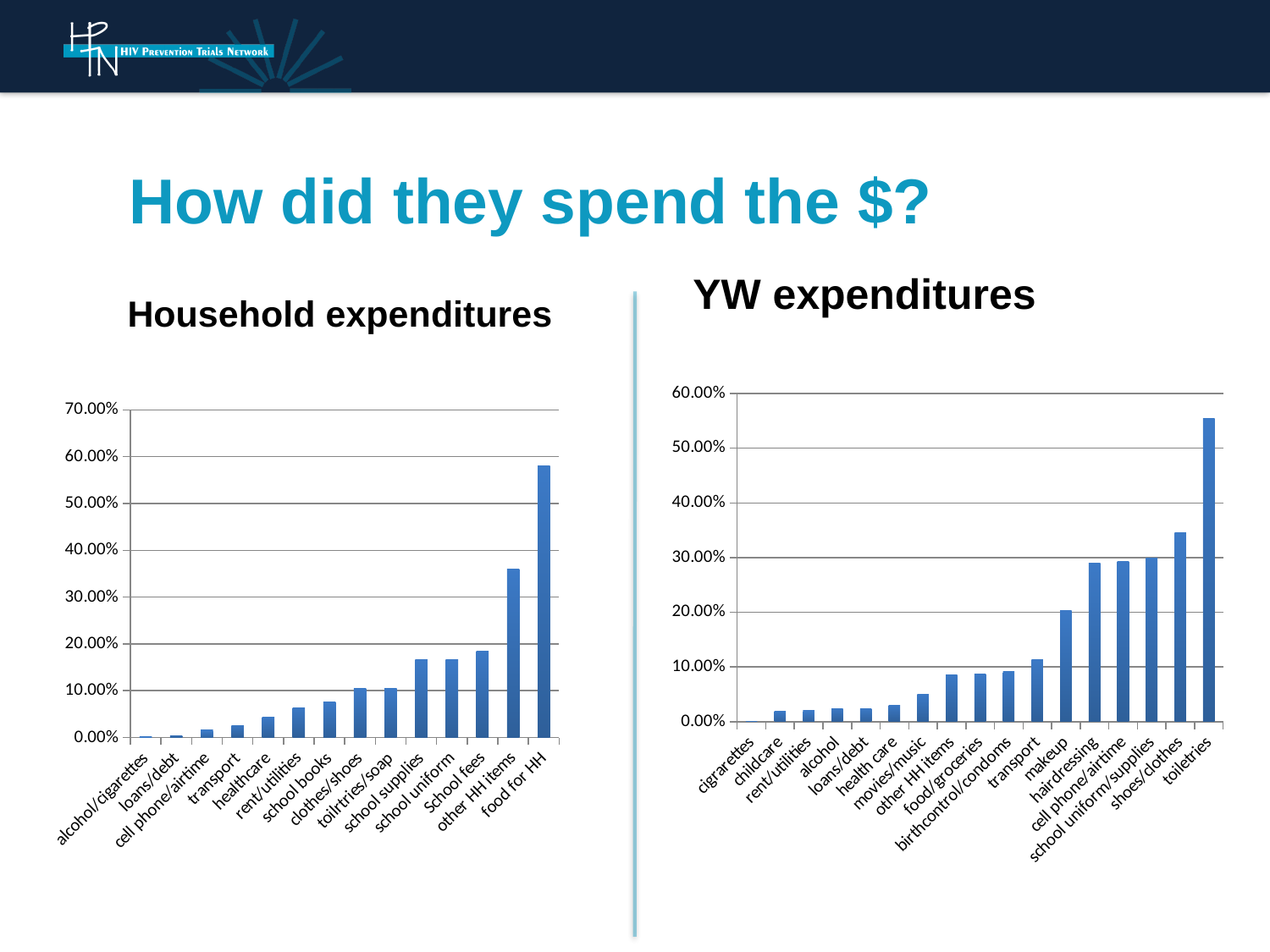
In the Household expenditures chart, which category has the highest value? food for HH In the Household expenditures chart, is the value for School fees greater or less than 20.00%? less In the Household expenditures chart, which category has the lowest value? alcohol/cigarettes In the YW expenditures chart, which category has the highest value? toiletries In the YW expenditures chart, do the values rise or fall from left to right along the x axis? rise In the Household expenditures chart, which is larger, other HH items or School fees? other HH items How many categories are shown in the Household expenditures chart? 14 In the YW expenditures chart, which category has the lowest value? cigrarettes How many categories are shown in the YW expenditures chart? 17 In the YW expenditures chart, is the value for toiletries greater or less than 50.00%? greater In the Household expenditures chart, is the value for food for HH greater or less than 50.00%? greater